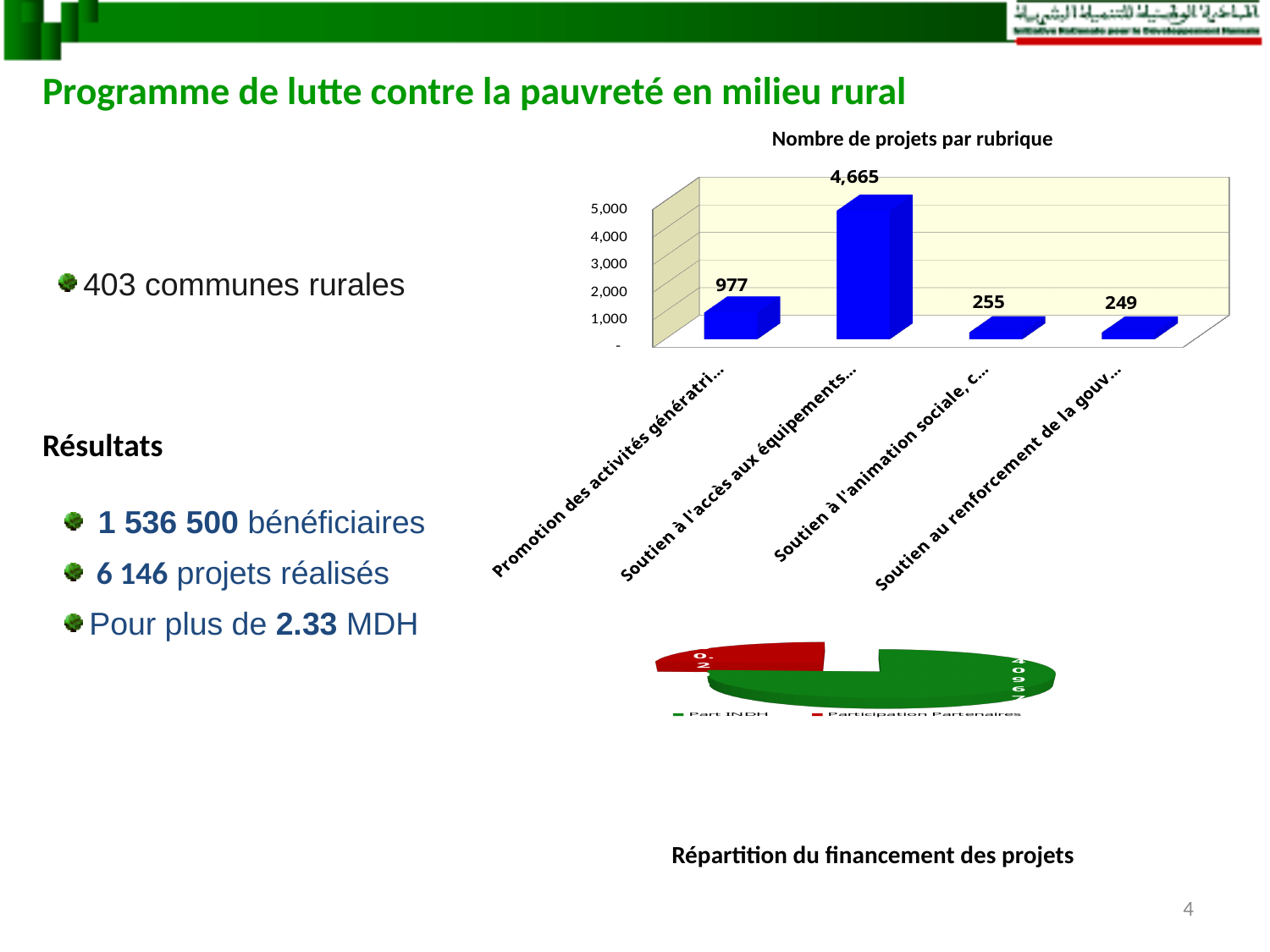
What kind of chart is 'Nombre de projets par rubrique'? Bar chart How many categories are shown in the 'Nombre de projets par rubrique' chart? 4 In the 'Nombre de projets par rubrique' chart, what is the value for 'Soutien à l'animation sociale, c...'? 255 How many series does the legend of the 'Répartition du financement des projets' chart list? 2 In the 'Nombre de projets par rubrique' chart, what is the value for 'Promotion des activités génératri...'? 977 In the 'Nombre de projets par rubrique' chart, what is the difference between the values for 'Soutien à l'accès aux équipements...' and 'Promotion des activités génératri...'? 3,688 In the 'Nombre de projets par rubrique' chart, how many projects are shown for 'Soutien à l'accès aux équipements...'? 4,665 In the 'Nombre de projets par rubrique' chart, which is larger: the value for 'Promotion des activités génératri...' or for 'Soutien à l'animation sociale, c...'? Promotion des activités génératri... In the 'Nombre de projets par rubrique' chart, which category has the highest number of projects? Soutien à l'accès aux équipements... In the 'Nombre de projets par rubrique' chart, which category has the lowest number of projects? Soutien au renforcement de la gouv... In the 'Nombre de projets par rubrique' chart, what is the difference between the values for 'Soutien à l'animation sociale, c...' and 'Soutien au renforcement de la gouv...'? 6 In the 'Nombre de projets par rubrique' chart, what is the value for 'Soutien au renforcement de la gouv...'? 249